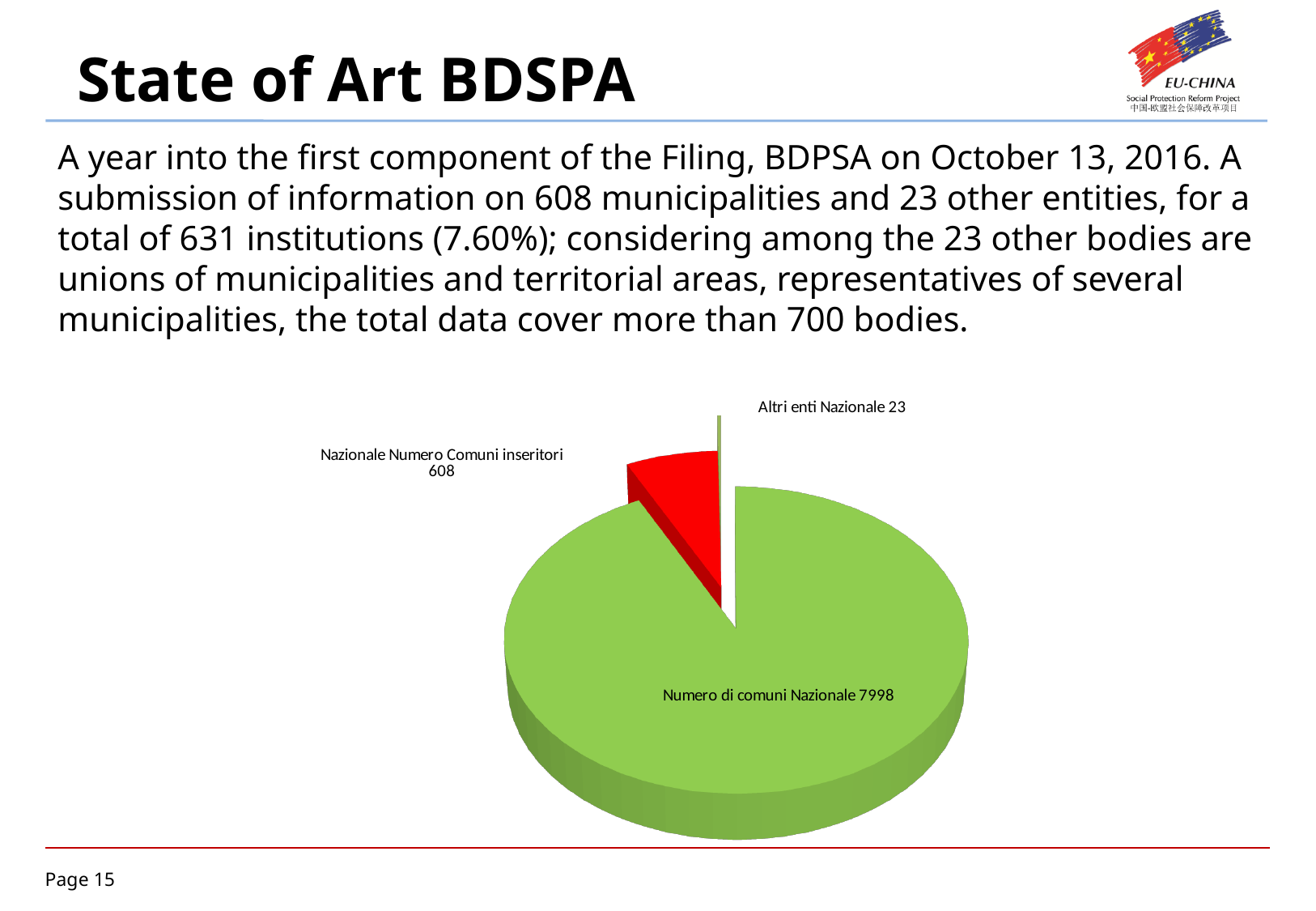
What is the difference between the values for Numero di comuni Nazionale and Nazionale Numero Comuni inseritori? 7390 Which slice of the pie chart is the largest? Numero di comuni Nazionale What is the value shown for Numero di comuni Nazionale? 7998 How many slices does the pie chart have? 3 What is the value shown for Nazionale Numero Comuni inseritori? 608 Which slice of the pie chart is the smallest? Altri enti Nazionale What colour is the slice for Nazionale Numero Comuni inseritori? Red Which is larger, the value for Nazionale Numero Comuni inseritori or the value for Altri enti Nazionale? Nazionale Numero Comuni inseritori What is the total of all three values shown in the pie chart? 8629 What is the value shown for Altri enti Nazionale? 23 What kind of chart is shown on the slide? Pie chart What is the difference between the values for Nazionale Numero Comuni inseritori and Altri enti Nazionale? 585